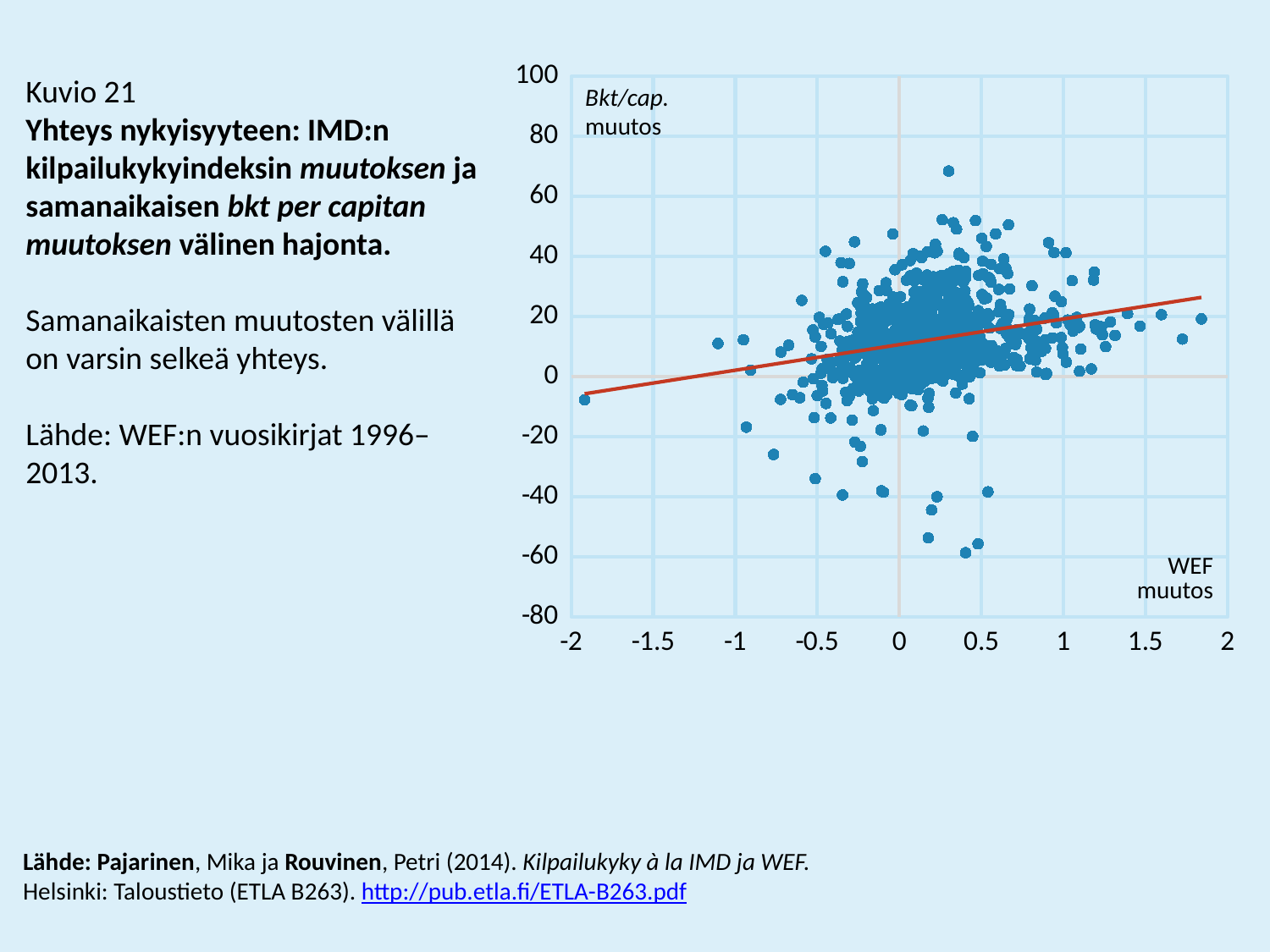
What kind of chart is shown on the slide? scatter plot Is the highest plotted Bkt/cap. muutos value greater or less than 60? greater What is the lowest value shown on the y axis of the chart? -80 What is the label of the x axis of the chart? WEF muutos Do the plotted values tend to rise or fall as the WEF muutos value increases along the x axis? rise Is the lowest plotted Bkt/cap. muutos value greater or less than -40? less Is the value of the red trend line at the left end of the chart greater or less than 0? less What is the highest value shown on the x axis of the chart? 2 What is the label of the y axis of the chart? Bkt/cap. muutos What is the lowest value shown on the x axis of the chart? -2 What is the highest value shown on the y axis of the chart? 100